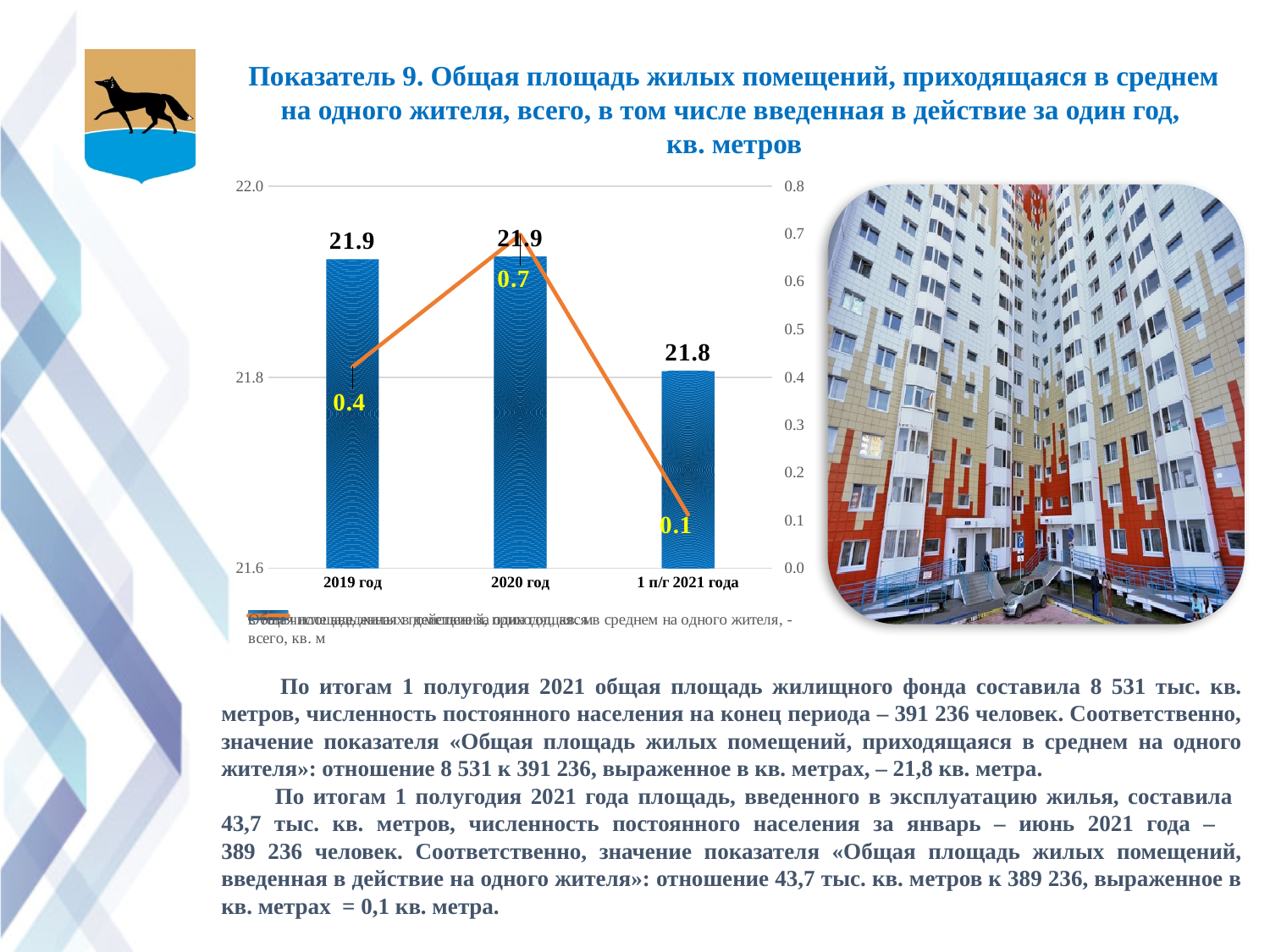
What is the line value (area introduced per resident) for 2020 год? 0.7 What is the bar value for 2019 год? 21.9 What is the line value (area introduced per resident) for 2019 год? 0.4 What is the line value (area introduced per resident) for 1 п/г 2021 года? 0.1 How many periods (categories) are shown on the x axis? 3 Which period has the lowest bar value? 1 п/г 2021 года What is the bar value for 1 п/г 2021 года? 21.8 What is the difference between the line values for 2020 год and 1 п/г 2021 года? 0.6 In which period does the line series reach its highest value? 2020 год Which is larger: the line value for 2019 год or for 2020 год? 2020 год In which period does the line series have its lowest value? 1 п/г 2021 года What kind of chart is shown on the slide? Combined bar and line chart